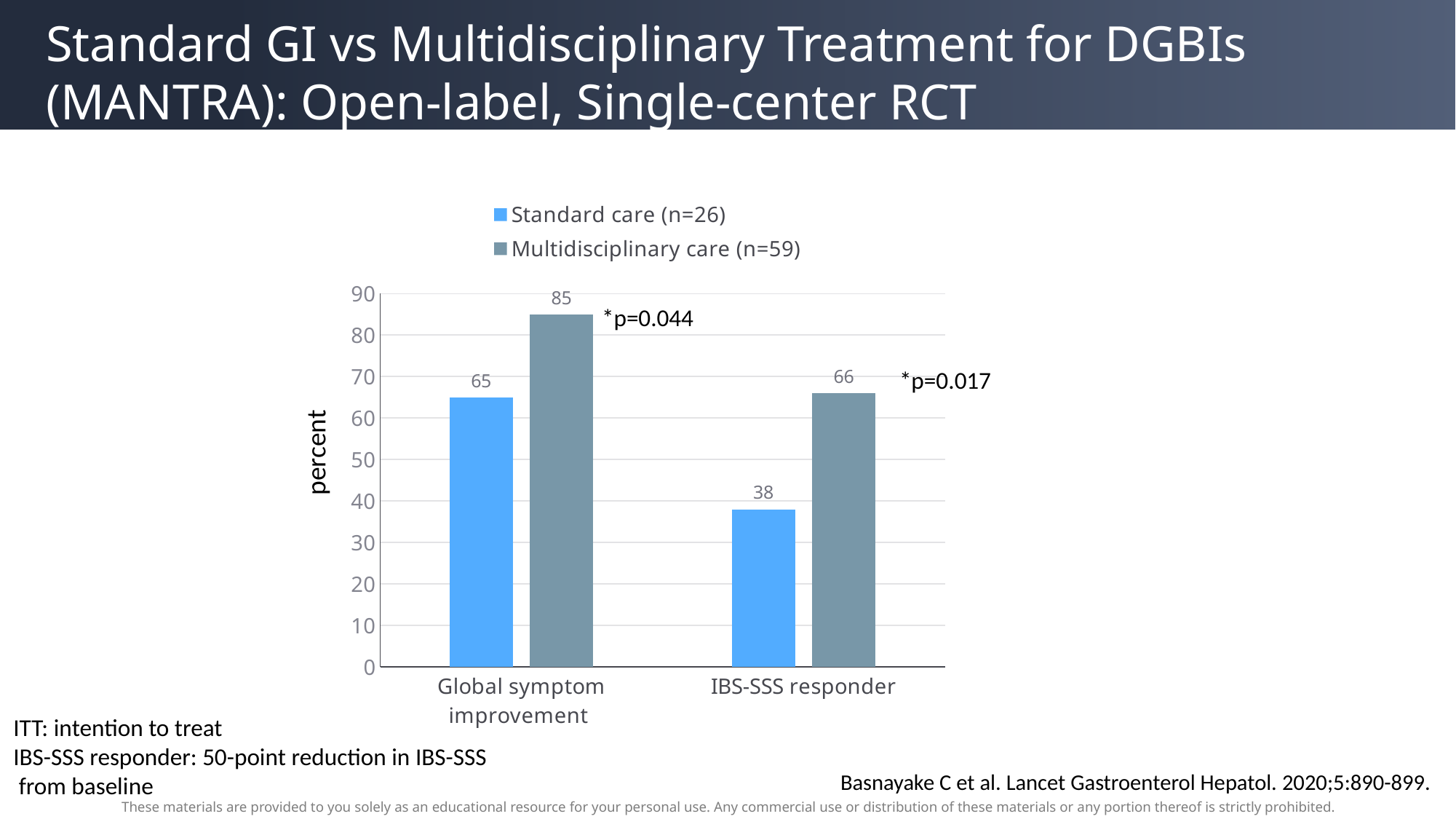
What is the difference between Multidisciplinary care and Standard care for IBS-SSS responder? 28 What is the value for Multidisciplinary care (n=59) for Global symptom improvement? 85 Which bar has the lowest value on the chart? Standard care (n=26), IBS-SSS responder What kind of chart is shown on the slide? Bar chart How many series does the legend list? 2 What is the value for Standard care (n=26) for Global symptom improvement? 65 Which bar has the highest value on the chart? Multidisciplinary care (n=59), Global symptom improvement Which series has the larger value for IBS-SSS responder, Standard care or Multidisciplinary care? Multidisciplinary care (n=59) What is the value for Multidisciplinary care (n=59) for IBS-SSS responder? 66 What is the value for Standard care (n=26) for IBS-SSS responder? 38 What is the difference between Multidisciplinary care and Standard care for Global symptom improvement? 20 What is the label on the vertical axis of the chart? percent